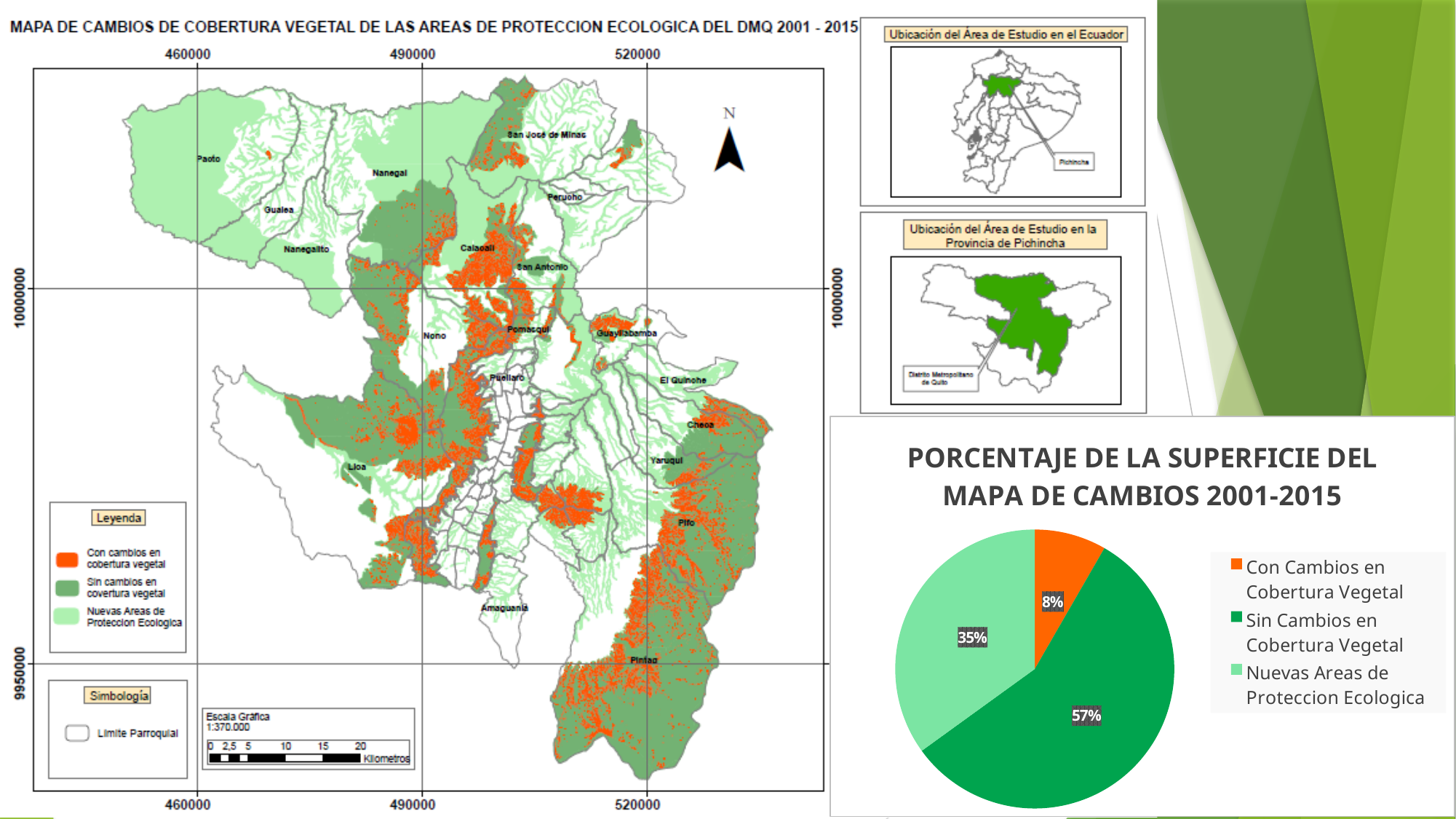
How many slices does the pie chart have? 3 In the pie chart, what percentage is shown for 'Nuevas Areas de Proteccion Ecologica'? 35% How many entries does the pie chart's legend list? 3 What kind of chart is shown under the title 'PORCENTAJE DE LA SUPERFICIE DEL MAPA DE CAMBIOS 2001-2015'? Pie chart What colour is the 'Con Cambios en Cobertura Vegetal' slice in the pie chart? Orange In the pie chart, what is the difference in percentage points between 'Nuevas Areas de Proteccion Ecologica' and 'Con Cambios en Cobertura Vegetal'? 27 In the pie chart, which category has the smallest share? Con Cambios en Cobertura Vegetal In the pie chart, what percentage is shown for 'Sin Cambios en Cobertura Vegetal'? 57% In the pie chart, which category has the largest share? Sin Cambios en Cobertura Vegetal In the pie chart, which is larger: 'Nuevas Areas de Proteccion Ecologica' or 'Con Cambios en Cobertura Vegetal'? Nuevas Areas de Proteccion Ecologica In the pie chart, what percentage is shown for 'Con Cambios en Cobertura Vegetal'? 8% In the pie chart, what is the difference in percentage points between 'Sin Cambios en Cobertura Vegetal' and 'Nuevas Areas de Proteccion Ecologica'? 22